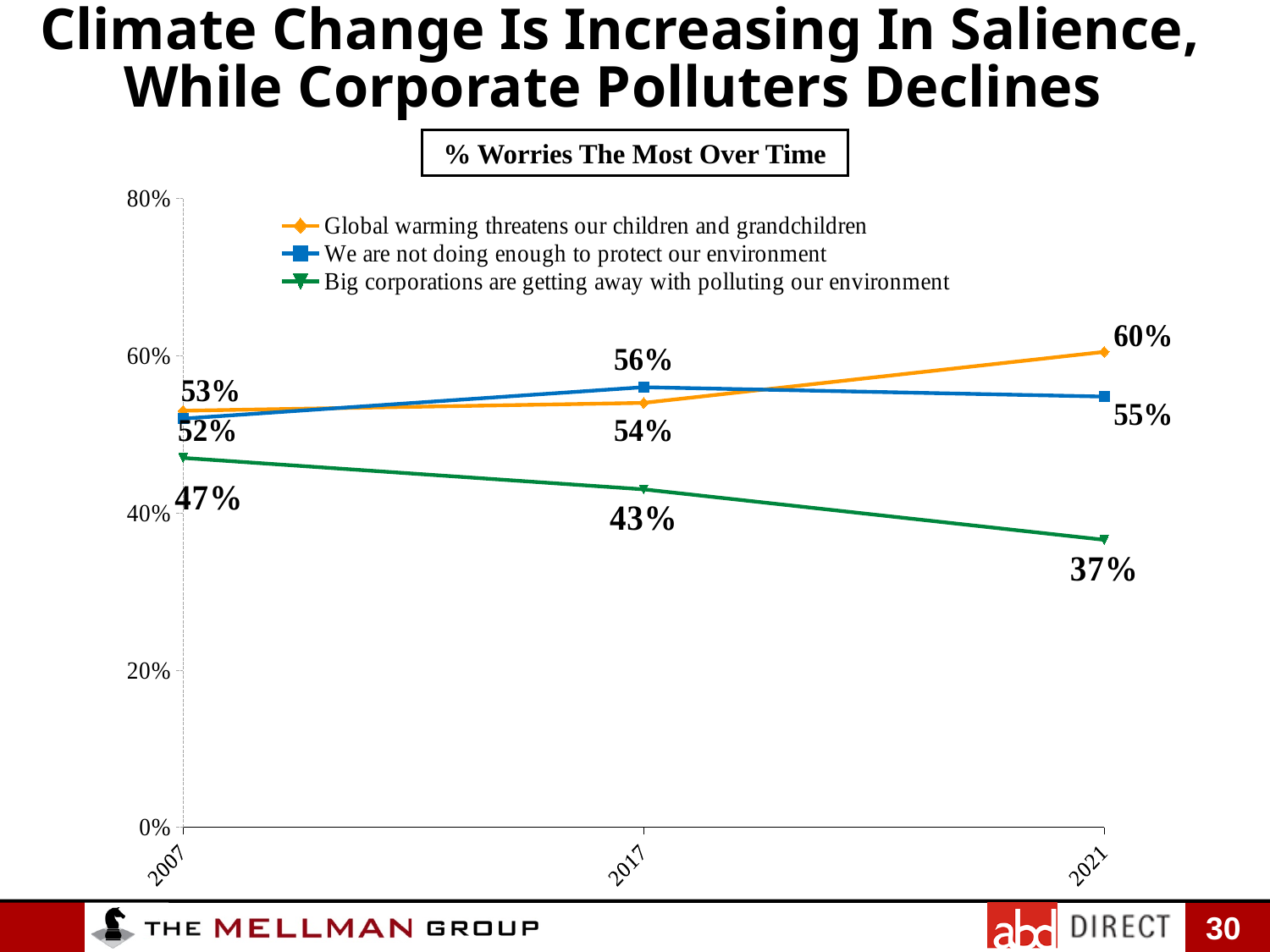
What is the value for 'We are not doing enough to protect our environment' in 2017? 56% What is the value for 'Big corporations are getting away with polluting our environment' in 2021? 37% How many series does the legend list? 3 In 2017, which is larger: 'We are not doing enough to protect our environment' or 'Global warming threatens our children and grandchildren'? We are not doing enough to protect our environment What is the value for 'Big corporations are getting away with polluting our environment' in 2007? 47% Which series has the highest value in 2021? Global warming threatens our children and grandchildren What kind of chart is shown on the slide? line chart What is the value for 'Global warming threatens our children and grandchildren' in 2021? 60% Does the 'Big corporations are getting away with polluting our environment' line rise or fall from 2007 to 2021? fall By how many percentage points did 'Big corporations are getting away with polluting our environment' fall from 2007 to 2021? 10 percentage points How many years are plotted along the x axis? 3 What is the title shown in the box above the chart? % Worries The Most Over Time